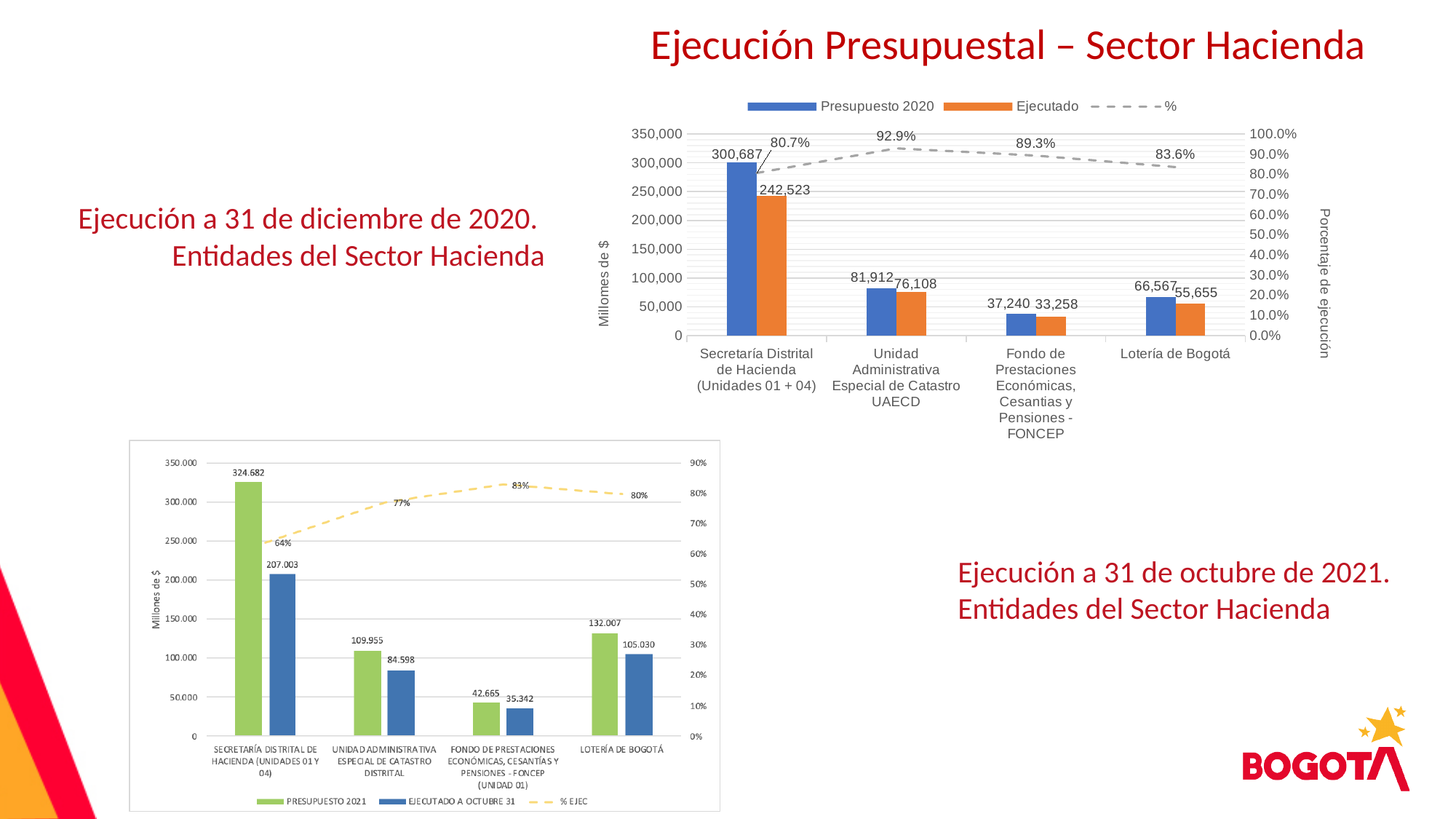
In the top-right chart (Ejecución a 31 de diciembre de 2020), what is the Ejecutado value for Lotería de Bogotá? 55,655 In the top-right chart (Ejecución a 31 de diciembre de 2020), what execution percentage is shown for Unidad Administrativa Especial de Catastro UAECD? 92.9% In the top-right chart (Ejecución a 31 de diciembre de 2020), how many series does the legend list? 3 In the top-right chart (Ejecución a 31 de diciembre de 2020), what is the Presupuesto 2020 value for Secretaría Distrital de Hacienda (Unidades 01 + 04)? 300,687 In the top-right chart (Ejecución a 31 de diciembre de 2020), what is the difference between Presupuesto 2020 and Ejecutado for Secretaría Distrital de Hacienda (Unidades 01 + 04)? 58,164 In the top-right chart (Ejecución a 31 de diciembre de 2020), which entity has the lowest Presupuesto 2020? Fondo de Prestaciones Económicas, Cesantias y Pensiones - FONCEP In the bottom-left chart (Ejecución a 31 de octubre de 2021), which entity has the highest % EJEC? FONDO DE PRESTACIONES ECONÓMICAS, CESANTÍAS Y PENSIONES - FONCEP (UNIDAD 01) In the bottom-left chart (Ejecución a 31 de octubre de 2021), what is the PRESUPUESTO 2021 value for LOTERÍA DE BOGOTÁ? 132.007 In the bottom-left chart (Ejecución a 31 de octubre de 2021), which is larger: the EJECUTADO A OCTUBRE 31 value for UNIDAD ADMINISTRATIVA ESPECIAL DE CATASTRO DISTRITAL or for LOTERÍA DE BOGOTÁ? LOTERÍA DE BOGOTÁ In the bottom-left chart (Ejecución a 31 de octubre de 2021), what is the EJECUTADO A OCTUBRE 31 value for FONDO DE PRESTACIONES ECONÓMICAS, CESANTÍAS Y PENSIONES - FONCEP (UNIDAD 01)? 35.342 In the bottom-left chart (Ejecución a 31 de octubre de 2021), what is the difference between PRESUPUESTO 2021 and EJECUTADO A OCTUBRE 31 for SECRETARÍA DISTRITAL DE HACIENDA (UNIDADES 01 Y 04)? 117.679 In the bottom-left chart (Ejecución a 31 de octubre de 2021), how many entities are shown on the x axis? 4